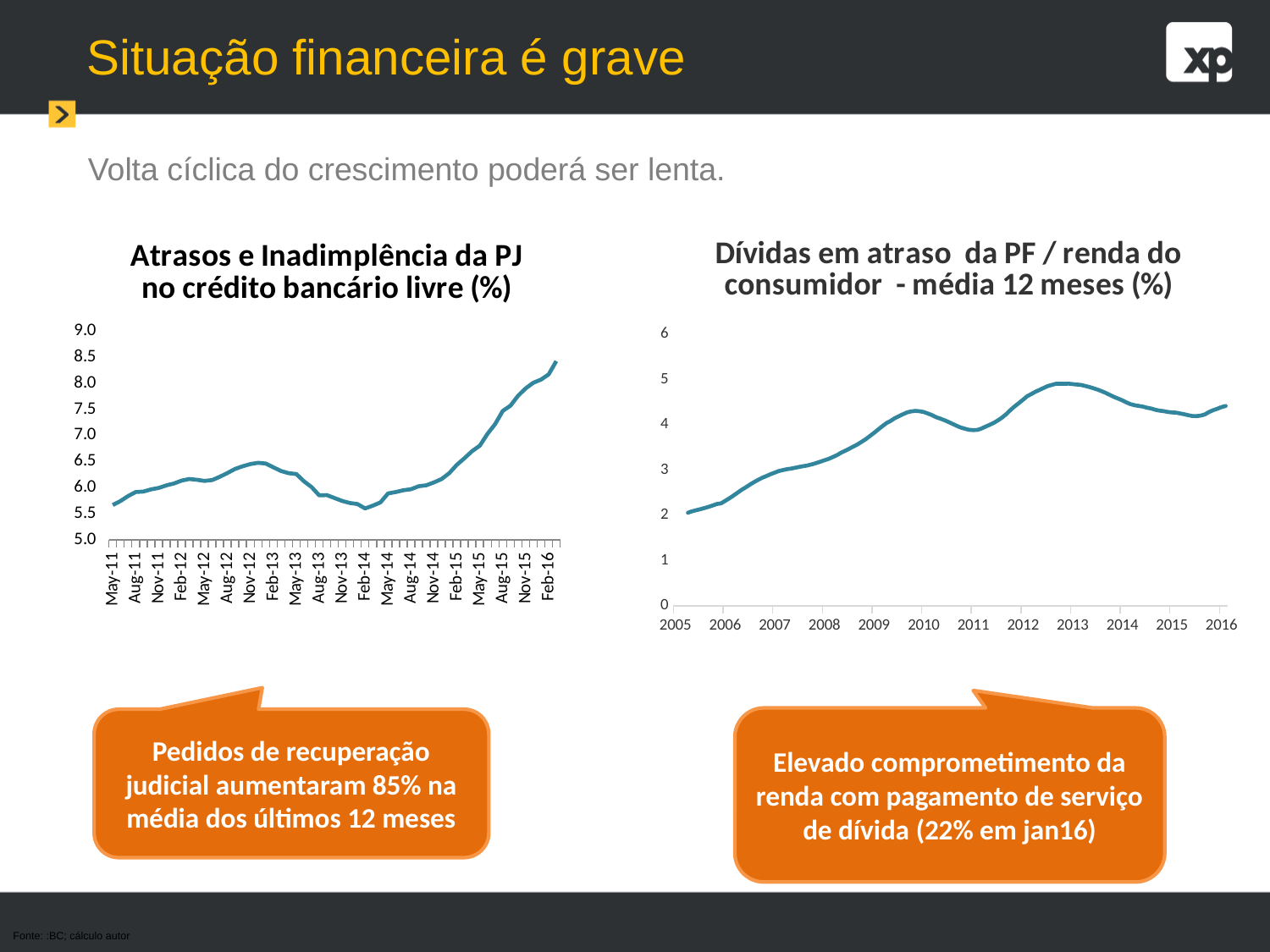
In the left chart, 'Atrasos e Inadimplência da PJ', is the value for Feb-14 greater or less than 6.0? less In the left chart, 'Atrasos e Inadimplência da PJ', does the line rise or fall between Feb-14 and Feb-16? rise In the left chart, 'Atrasos e Inadimplência da PJ', is the value for Feb-16 greater or less than 8.0? greater In the right chart, 'Dívidas em atraso da PF', does the line rise or fall between 2005 and 2010? rise In the right chart, 'Dívidas em atraso da PF', at which x-axis label is the line at its lowest value? 2005 What kind of chart is the left chart, 'Atrasos e Inadimplência da PJ no crédito bancário livre (%)'? line chart In the right chart, 'Dívidas em atraso da PF', is the value for 2005 greater or less than 3? less What is the title of the right chart on the slide? Dívidas em atraso da PF / renda do consumidor - média 12 meses (%) What kind of chart is the right chart, 'Dívidas em atraso da PF / renda do consumidor - média 12 meses (%)'? line chart